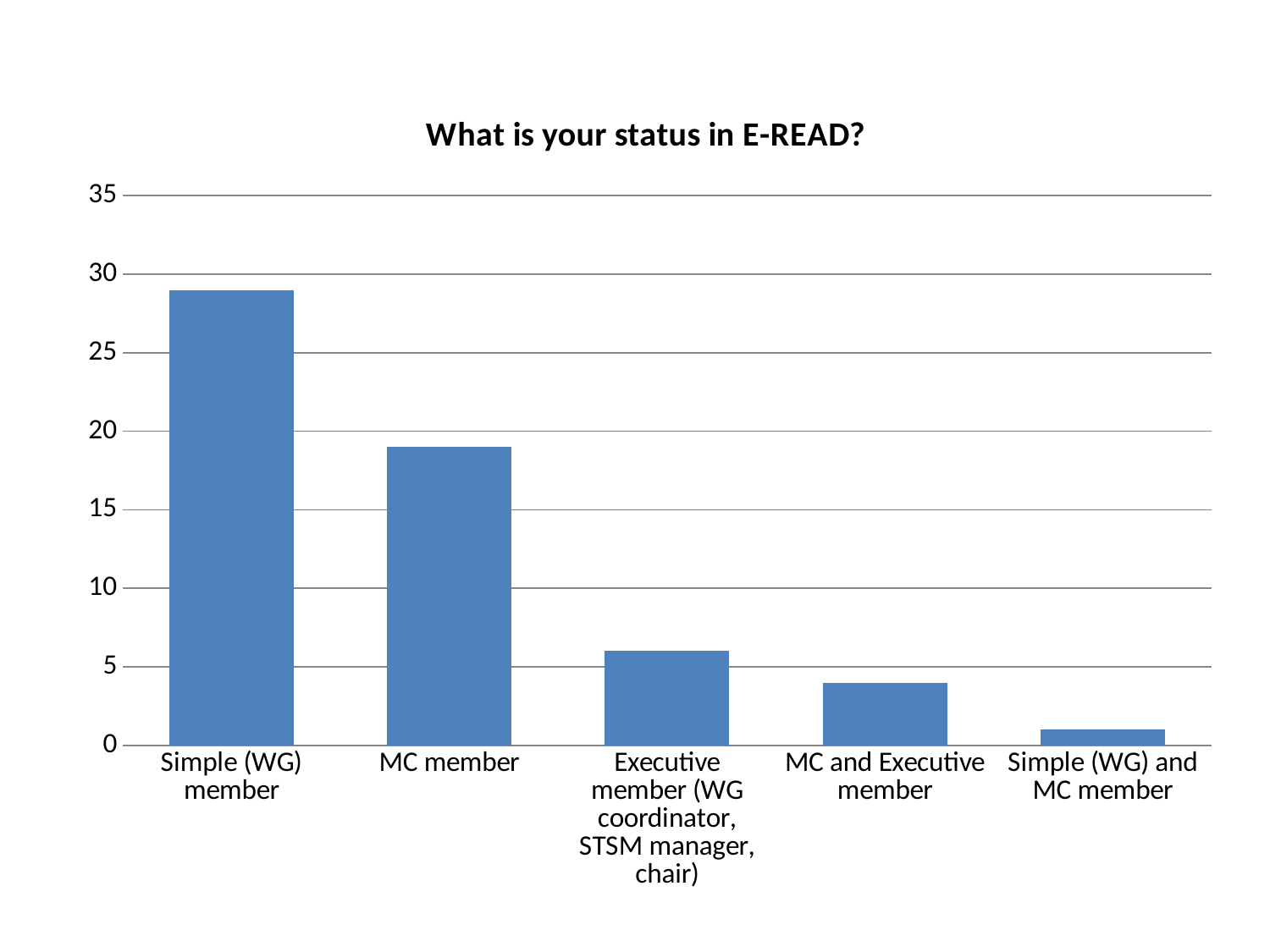
What is the highest value shown on the vertical axis? 35 What type of chart is shown on the slide? bar chart How many categories are shown on the x axis of the chart? 5 Which is larger, the value for MC member or the value for MC and Executive member? MC member Which category has the lowest value? Simple (WG) and MC member Which category has the highest value? Simple (WG) member Is the value for Executive member (WG coordinator, STSM manager, chair) greater or less than 5? greater Do the values rise or fall moving from left to right along the x axis? fall Is the value for MC and Executive member greater or less than 5? less Is the value for MC member greater or less than 20? less What is the title of the chart? What is your status in E-READ?